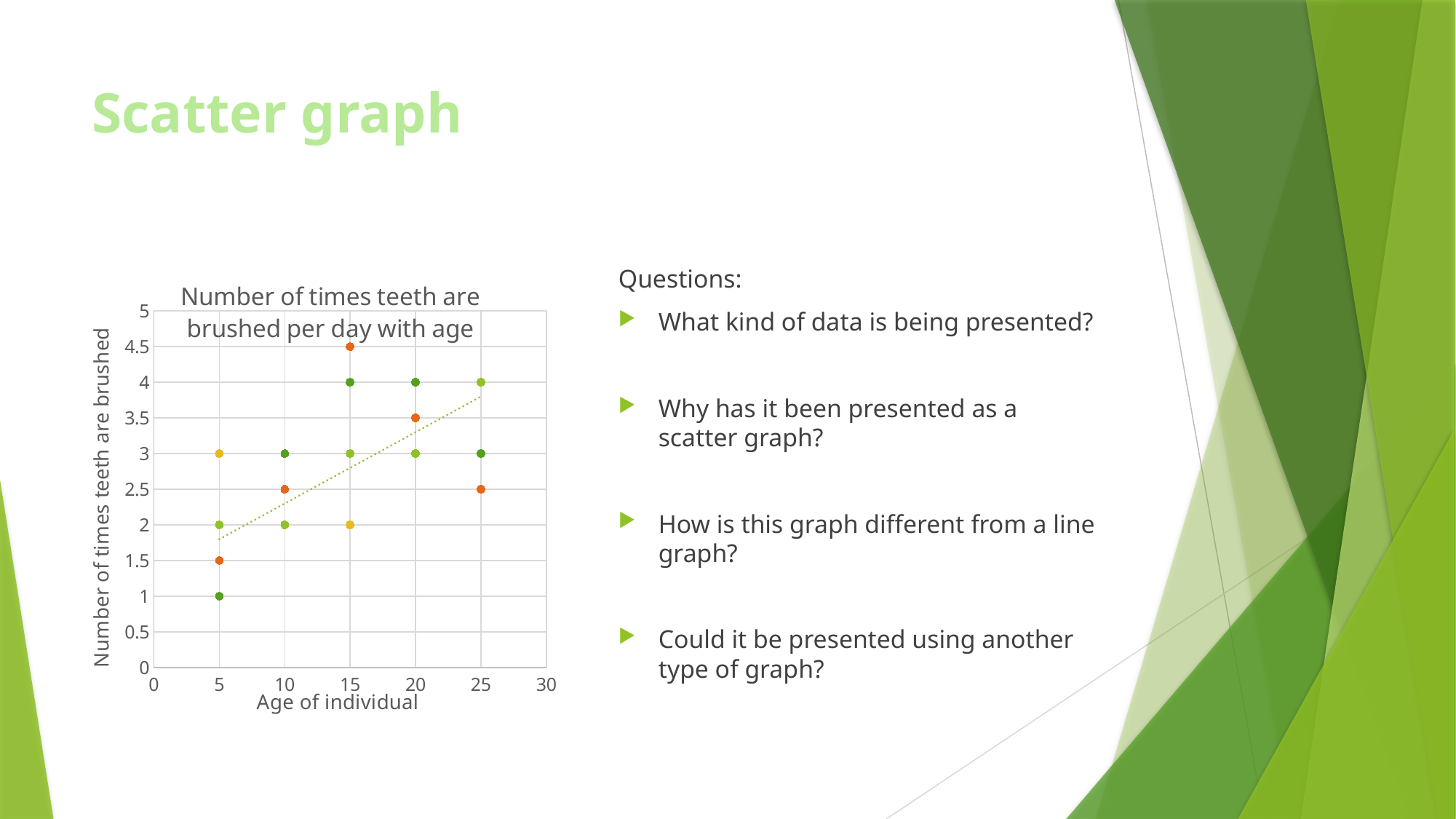
What is the difference between the highest value at age 15 and the lowest value at age 5? 3.5 Does the dotted trend line rise or fall as age increases? Rises What is the lowest value plotted for age 25? 2.5 What is the highest value plotted for age 20? 4 At what age does the lowest plotted value (1 time) occur? 5 What kind of chart is shown on the slide? Scatter graph How many distinct ages have data points plotted on the chart? 5 What is the label of the x axis of the chart? Age of individual What is the lowest number of times teeth are brushed plotted on the chart? 1 At what age does the highest plotted value (4.5 times) occur? 15 What is the highest number of times teeth are brushed plotted on the chart? 4.5 What is the title of the chart? Number of times teeth are brushed per day with age